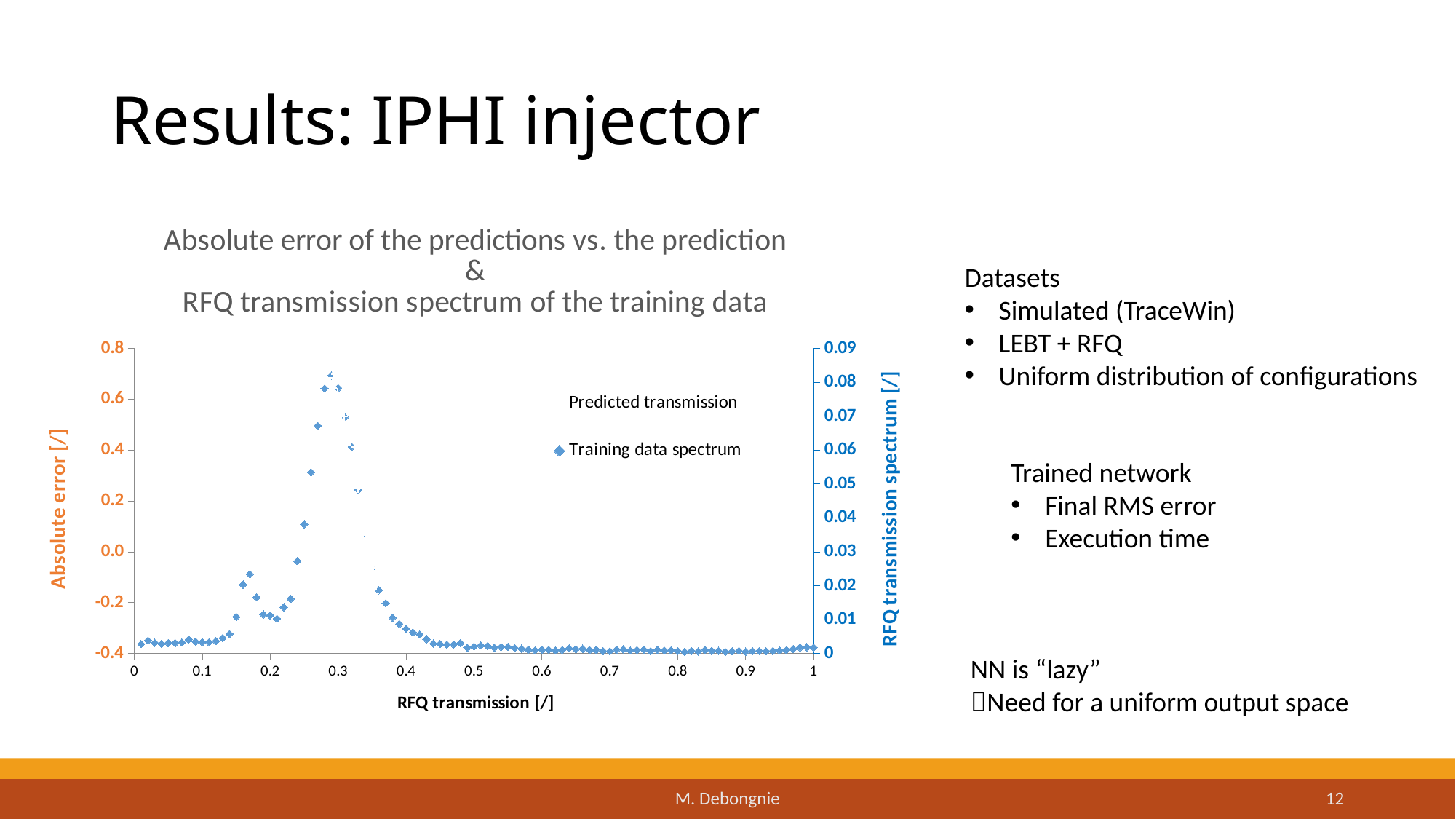
Is the Training data spectrum value at an RFQ transmission of 0.1 greater or less than 0.02 on the right axis? less Is the Training data spectrum value at an RFQ transmission of 0.3 greater or less than 0.06 on the right axis? greater How many series does the chart legend list? 2 Between RFQ transmission 0.3 and 0.4, does the Training data spectrum rise or fall? fall Does the Training data spectrum reach its peak at an RFQ transmission below or above 0.5? below What kind of chart is shown on the slide? scatter chart Which is larger for the Training data spectrum: the value at RFQ transmission 0.3 or the value at 0.7? 0.3 Which is larger for the Training data spectrum: the value at RFQ transmission 0.15 or the value at 0.9? 0.15 Between RFQ transmission 0.2 and 0.3, does the Training data spectrum rise or fall? rise What is the title of the chart's x axis? RFQ transmission [/] What are the two series named in the chart legend? Predicted transmission; Training data spectrum